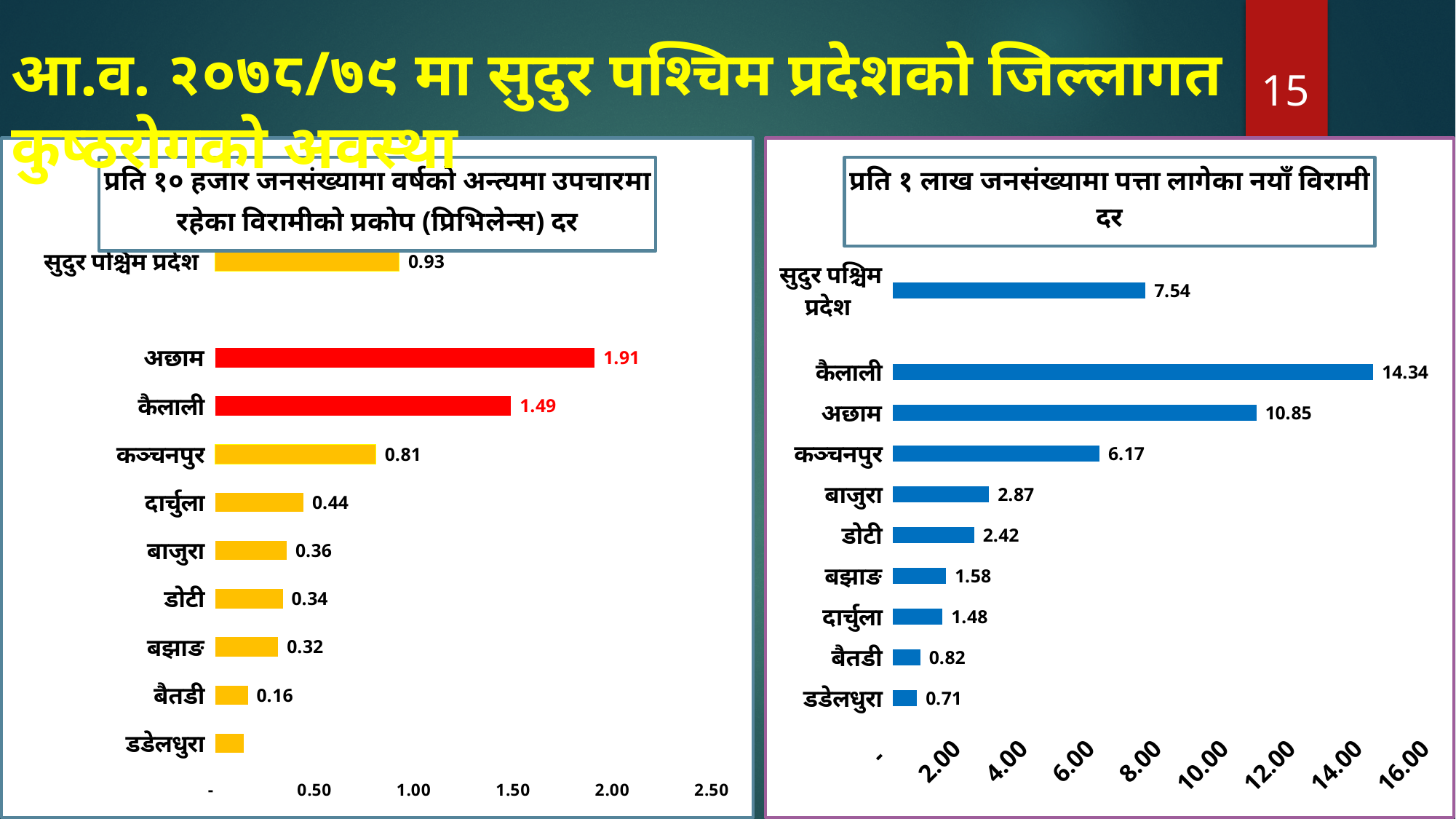
In the left chart, what is the difference between the values for अछाम and कैलाली? 0.42 In the left chart, which is larger, the value for कञ्चनपुर or the value for दार्चुला? कञ्चनपुर In the right chart, what is the difference between the values for कैलाली and अछाम? 3.49 In the right chart, which category has the lowest value? डडेलधुरा In the right chart, what is the value for कैलाली? 14.34 In the left chart, which two districts have red bars? अछाम and कैलाली How many categories are plotted in the right chart? 10 In the left chart, which district has the highest value? अछाम In the left chart, what is the value for अछाम? 1.91 In the left chart, is the value for डडेलधुरा greater or less than 0.50? less What kind of chart is the right chart? bar chart In the right chart, what is the value for सुदुर पश्चिम प्रदेश? 7.54